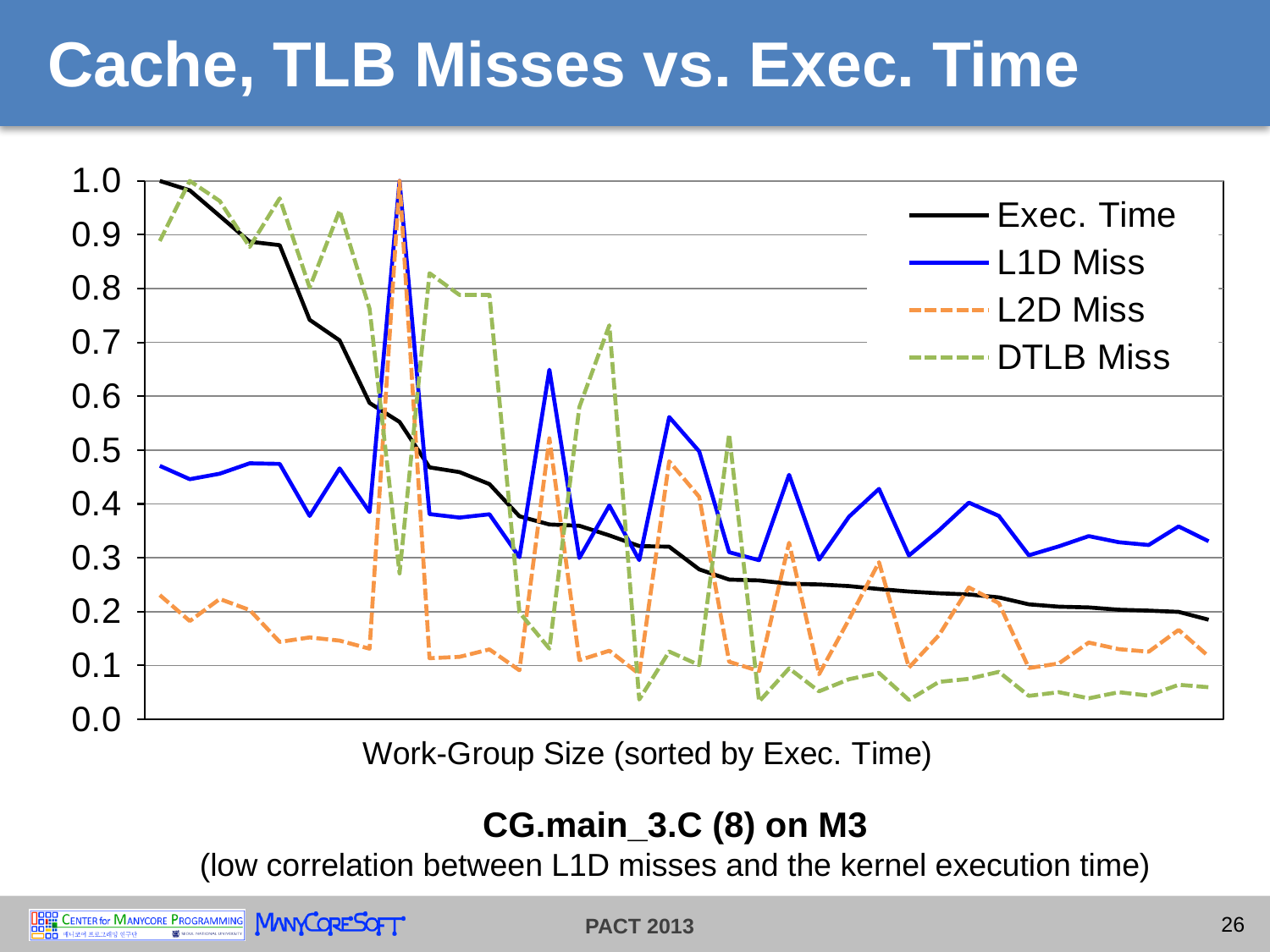
What is the highest value reached by the L1D Miss line? 1.0 At the right end of the chart, which is larger: the L1D Miss value or the Exec. Time value? L1D Miss Is the rightmost value of the Exec. Time line greater or less than 0.3? less Is the leftmost value of the L1D Miss line greater or less than 0.4? greater At the right end of the chart, which series has the lowest value? DTLB Miss What is the leftmost (first) value of the Exec. Time line? 1.0 Does the Exec. Time line rise or fall from left to right along the x axis? Fall How many series does the legend list? 4 Is the rightmost value of the DTLB Miss line greater or less than 0.1? less What kind of chart is shown on the slide? Line chart What is the label of the x axis? Work-Group Size (sorted by Exec. Time)